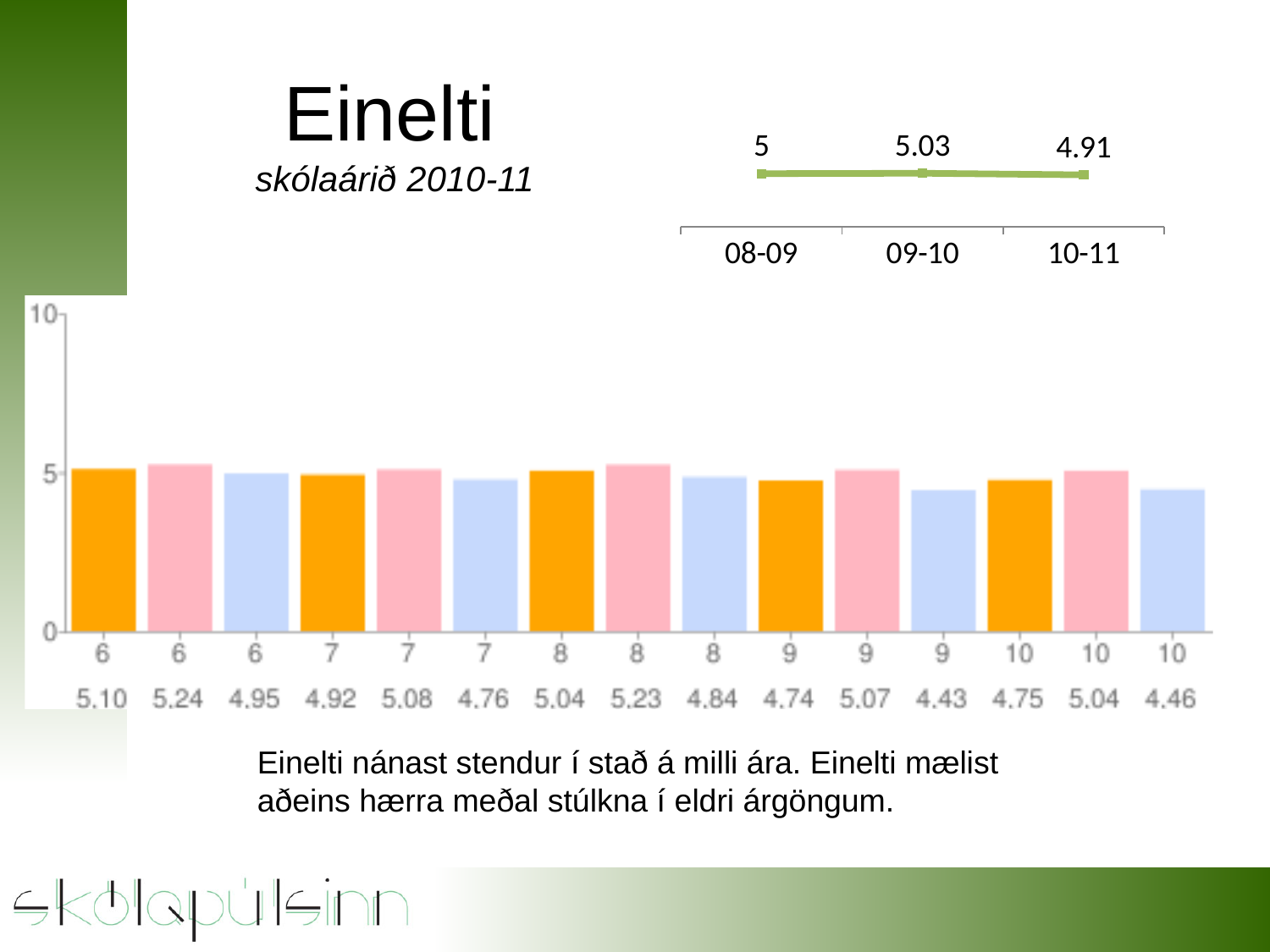
In the large bar chart, which is larger: the pink bar for grade 8 or the blue bar for grade 8? The pink bar for grade 8 What kind of chart is the large chart at the bottom of the slide? Bar chart In the line chart at the top right, what is the value for 10-11? 4.91 In the large bar chart, what is the value of the blue bar for grade 9? 4.43 In the large bar chart, what is the difference between the pink bar and the blue bar for grade 7? 0.32 In the line chart at the top right, what is the difference between the 09-10 value and the 10-11 value? 0.12 In the large bar chart, what is the value of the orange bar for grade 10? 4.75 In the line chart at the top right, how many points are plotted? 3 In the line chart at the top right, what is the value for 09-10? 5.03 In the large bar chart, which bar has the lowest value? The blue bar for grade 9 (4.43) In the large bar chart, what is the value of the pink bar for grade 6? 5.24 In the line chart at the top right, which year has the highest value? 09-10